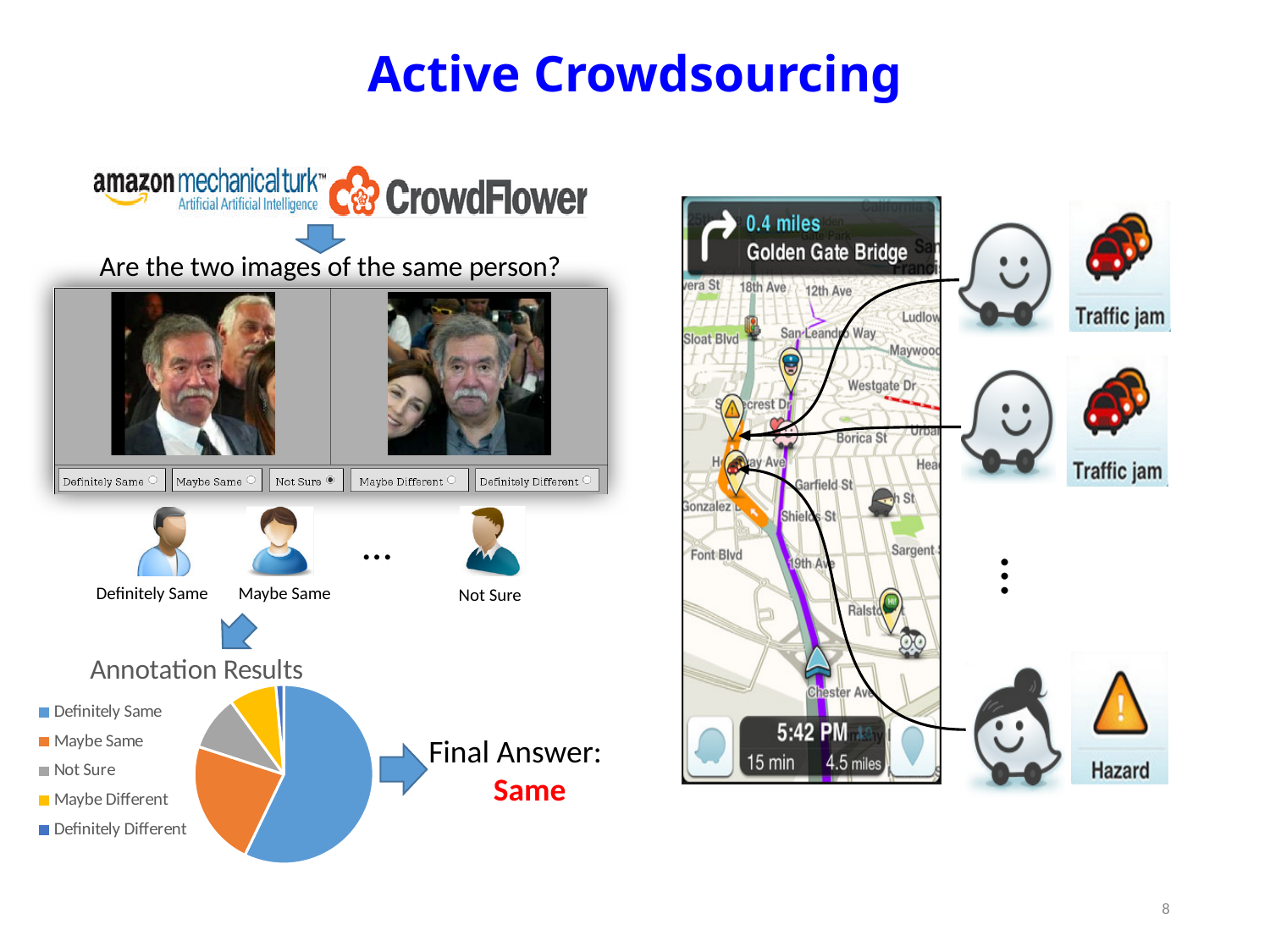
How many categories does the legend of the "Annotation Results" pie chart list? 5 What kind of chart is the "Annotation Results" chart? pie chart What is the title of the pie chart on the slide? Annotation Results In the "Annotation Results" pie chart, which slice is larger: Not Sure or Definitely Different? Not Sure In the "Annotation Results" pie chart, which slice is larger: Maybe Different or Definitely Different? Maybe Different In the "Annotation Results" pie chart, which category has the smallest slice? Definitely Different In the "Annotation Results" pie chart, which category is shown in orange? Maybe Same In the "Annotation Results" pie chart, which slice is larger: Definitely Same or Maybe Same? Definitely Same In the "Annotation Results" pie chart, which category has the largest slice? Definitely Same